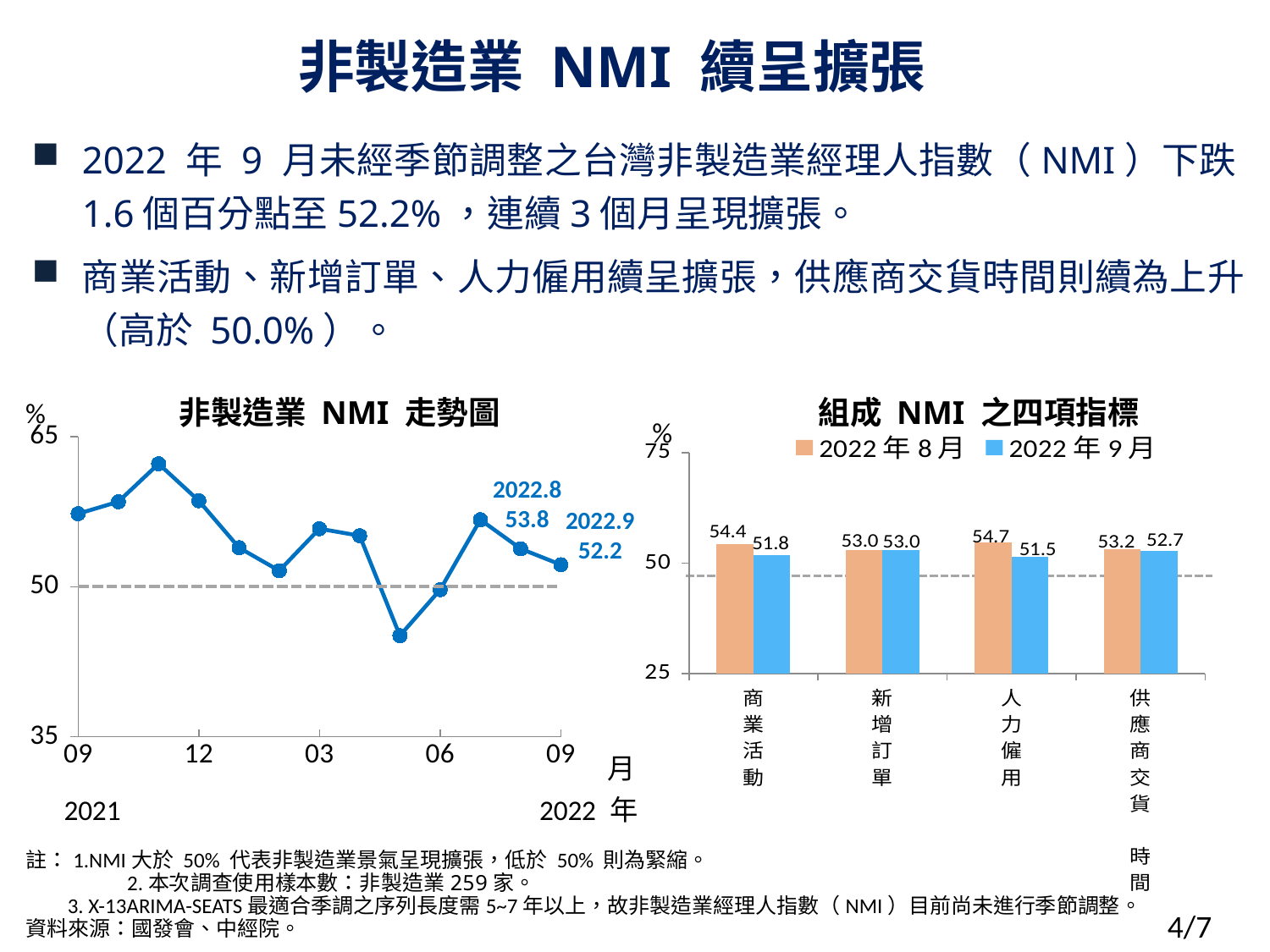
In the bar chart 組成 NMI 之四項指標, which is larger for 供應商交貨時間: the 2022 年 8 月 value or the 2022 年 9 月 value? 2022 年 8 月 In the line chart 非製造業 NMI 走勢圖, by how much did the NMI fall from 2022.8 to 2022.9? 1.6 What kind of chart is 非製造業 NMI 走勢圖? line chart In the bar chart 組成 NMI 之四項指標, which indicator has the highest value for 2022 年 8 月? 人力僱用 In the line chart 非製造業 NMI 走勢圖, how many data points are plotted? 13 How many series does the legend of the bar chart 組成 NMI 之四項指標 list? 2 In the bar chart 組成 NMI 之四項指標, what is the difference between the 2022 年 8 月 and 2022 年 9 月 values for 商業活動? 2.6 In the bar chart 組成 NMI 之四項指標, what is the value of 人力僱用 for 2022 年 9 月? 51.5 What kind of chart is 組成 NMI 之四項指標? bar chart In the line chart 非製造業 NMI 走勢圖, what is the NMI value labelled for 2022.8? 53.8 In the line chart 非製造業 NMI 走勢圖, is the value for 2022 month 05 greater or less than 50? less In the line chart 非製造業 NMI 走勢圖, what is the NMI value labelled for 2022.9? 52.2